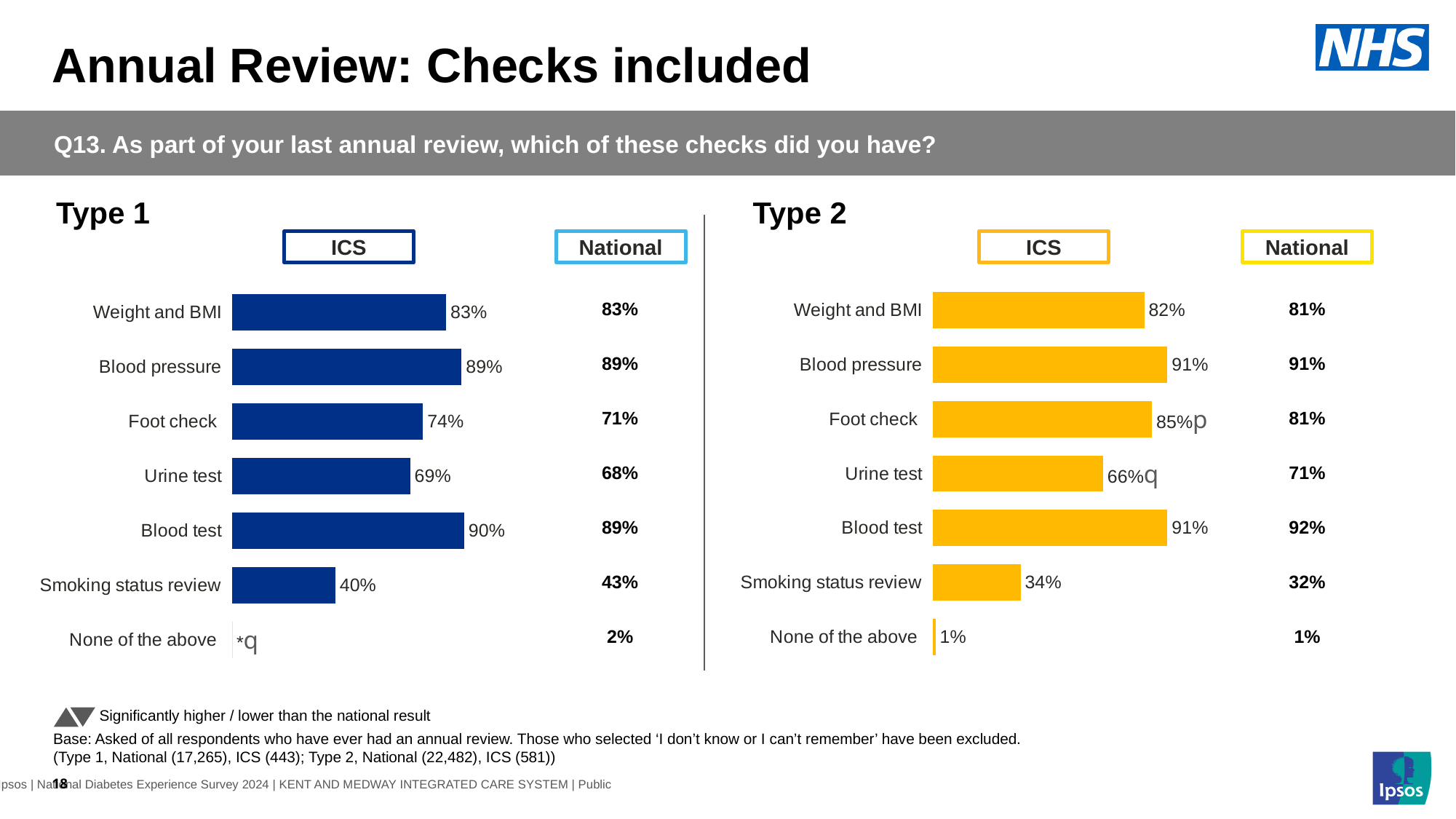
In the Type 2 chart, which is larger: the ICS value for Weight and BMI or the ICS value for Smoking status review? Weight and BMI In the Type 2 chart, what is the ICS value for Urine test? 66% In the Type 1 chart, what is the National value for Smoking status review? 43% In the Type 2 chart, what is the difference between the ICS and National values for Foot check? 4% In the Type 1 chart, what is the ICS value for Foot check? 74% In the Type 1 chart, what is the difference between the ICS values for Blood pressure and Smoking status review? 49% How many checks are listed in the Type 1 chart? 7 What colour are the bars in the Type 1 chart? Dark blue What kind of chart is used for the Type 2 ICS results? Bar chart In the Type 2 chart, which check has the lowest ICS value? None of the above In the Type 2 chart, what is the National value for Foot check? 81% In the Type 1 chart, which check has the highest ICS value? Blood test